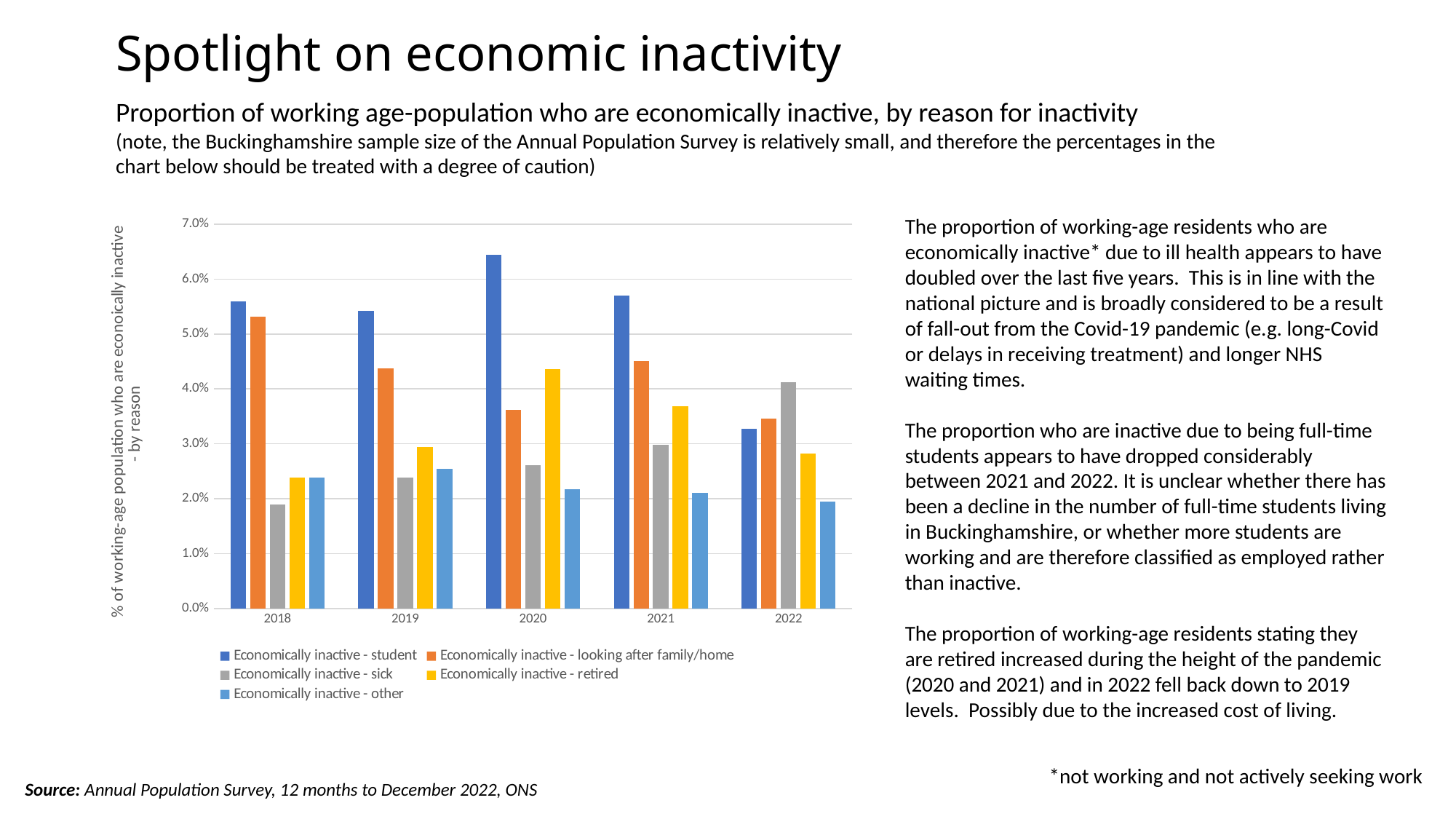
Does the 'Economically inactive - sick' series rise or fall from 2018 to 2022? rise How many series does the legend list? 5 In 2022, which is larger: 'Economically inactive - sick' or 'Economically inactive - student'? Economically inactive - sick Is the value for 'Economically inactive - student' in 2020 greater or less than 6.0%? greater Is the value for 'Economically inactive - sick' in 2018 greater or less than 2.0%? less What kind of chart is shown on the slide? Bar chart In which year is the 'Economically inactive - student' bar highest? 2020 Is the value for 'Economically inactive - retired' in 2020 greater or less than 4.0%? greater Which reason for inactivity has the lowest bar in 2018? Economically inactive - sick What is the highest tick value shown on the y axis? 7.0% How many years are shown on the x axis of the chart? 5 Which reason for inactivity has the highest bar in 2022? Economically inactive - sick